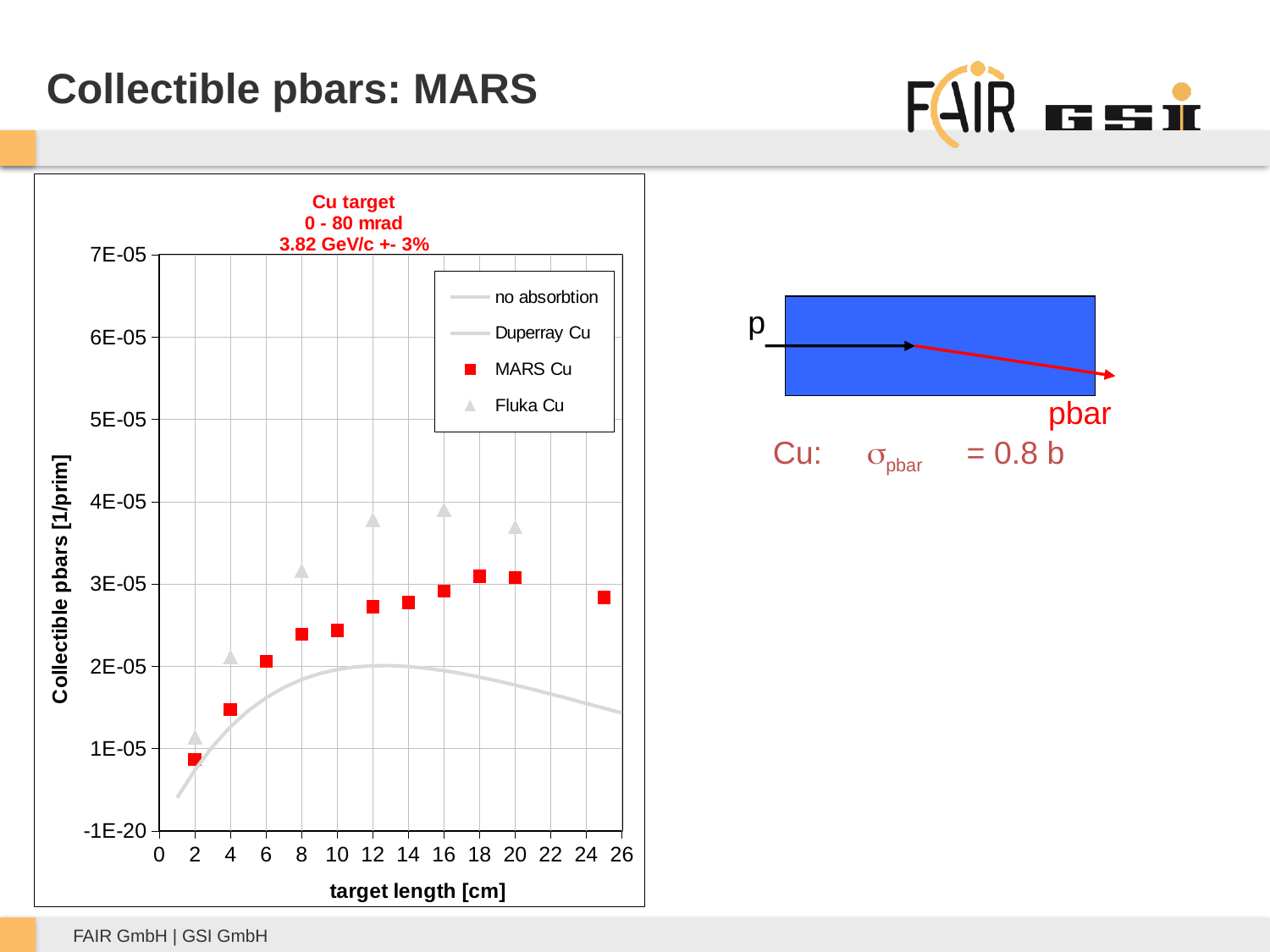
Is the MARS Cu value at a target length of 4 cm greater or less than 2E-05? less Is the MARS Cu value at a target length of 12 cm greater or less than 2E-05? greater At which target length is the MARS Cu value lowest? 2 cm What is the label of the x axis of the chart? target length [cm] How many series does the chart legend list? 4 What kind of chart is shown on the slide? scatter chart How many Fluka Cu data points are plotted on the chart? 6 Is the MARS Cu value at a target length of 25 cm greater or less than 3E-05? less At a target length of 12 cm, which series has the larger value, MARS Cu or Fluka Cu? Fluka Cu Do the MARS Cu values rise or fall as the target length increases from 2 cm to 18 cm? rise How many MARS Cu data points are plotted on the chart? 11